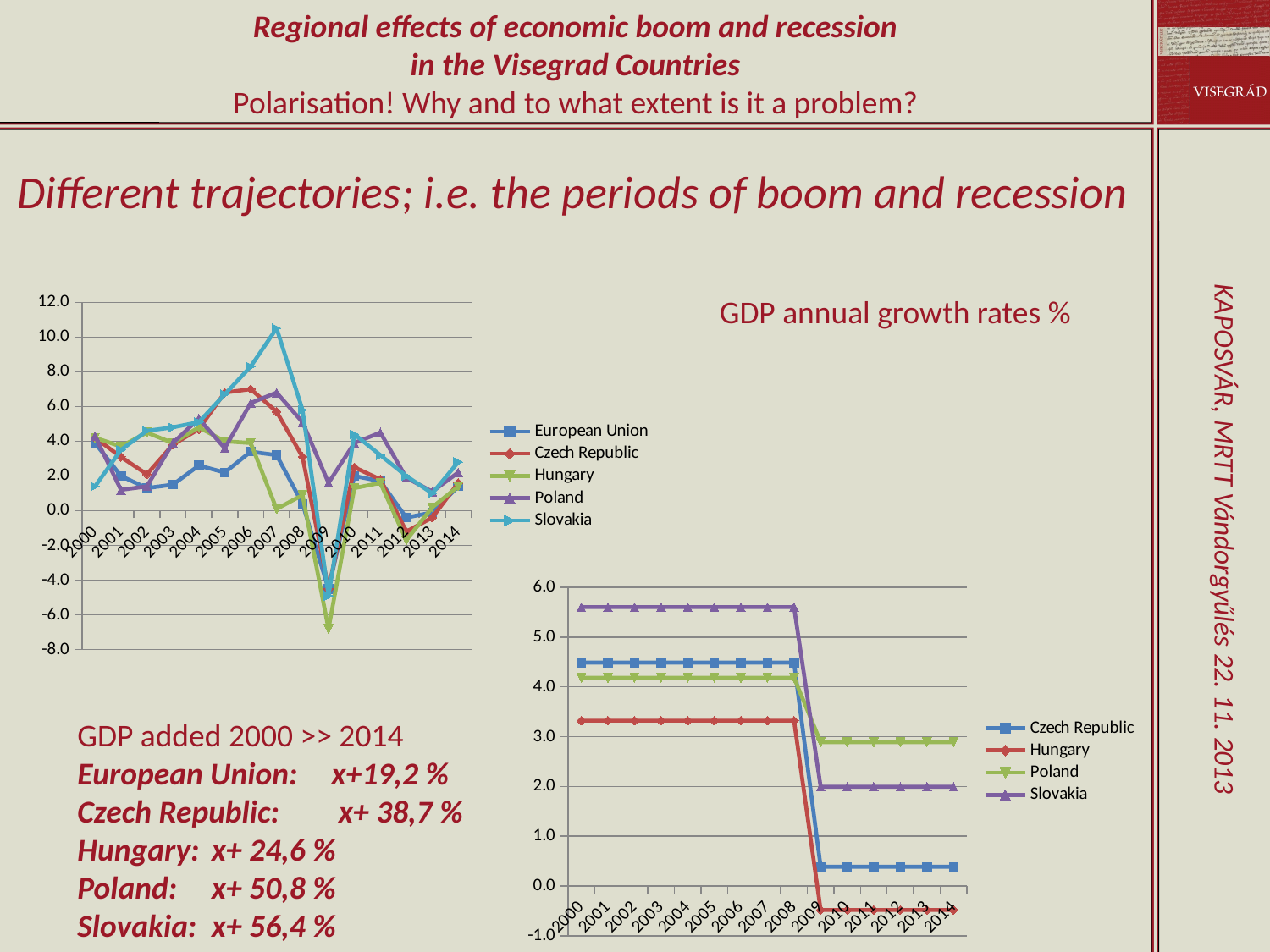
On the bottom-right chart, which series has the highest value from 2000 to 2008? Slovakia On the 'GDP annual growth rates %' chart, how many years are shown on the x axis? 15 On the 'GDP annual growth rates %' chart, which series has the lowest value in 2009? Hungary What kind of chart is the 'GDP annual growth rates %' chart? line chart On the bottom-right chart, do the values for all series rise or fall between 2008 and 2009? fall On the 'GDP annual growth rates %' chart, is the value for Slovakia in 2007 greater or less than 8.0? greater On the bottom-right chart, which series has the lowest value from 2010 to 2014? Hungary On the bottom-right chart, how many series does the legend list? 4 On the chart titled 'GDP annual growth rates %', how many series does the legend list? 5 On the bottom-right chart, is the value for Czech Republic in 2012 greater or less than 1.0? less On the 'GDP annual growth rates %' chart, which country has the highest value in 2007? Slovakia On the 'GDP annual growth rates %' chart, is the value for Hungary in 2009 greater or less than -6.0? less